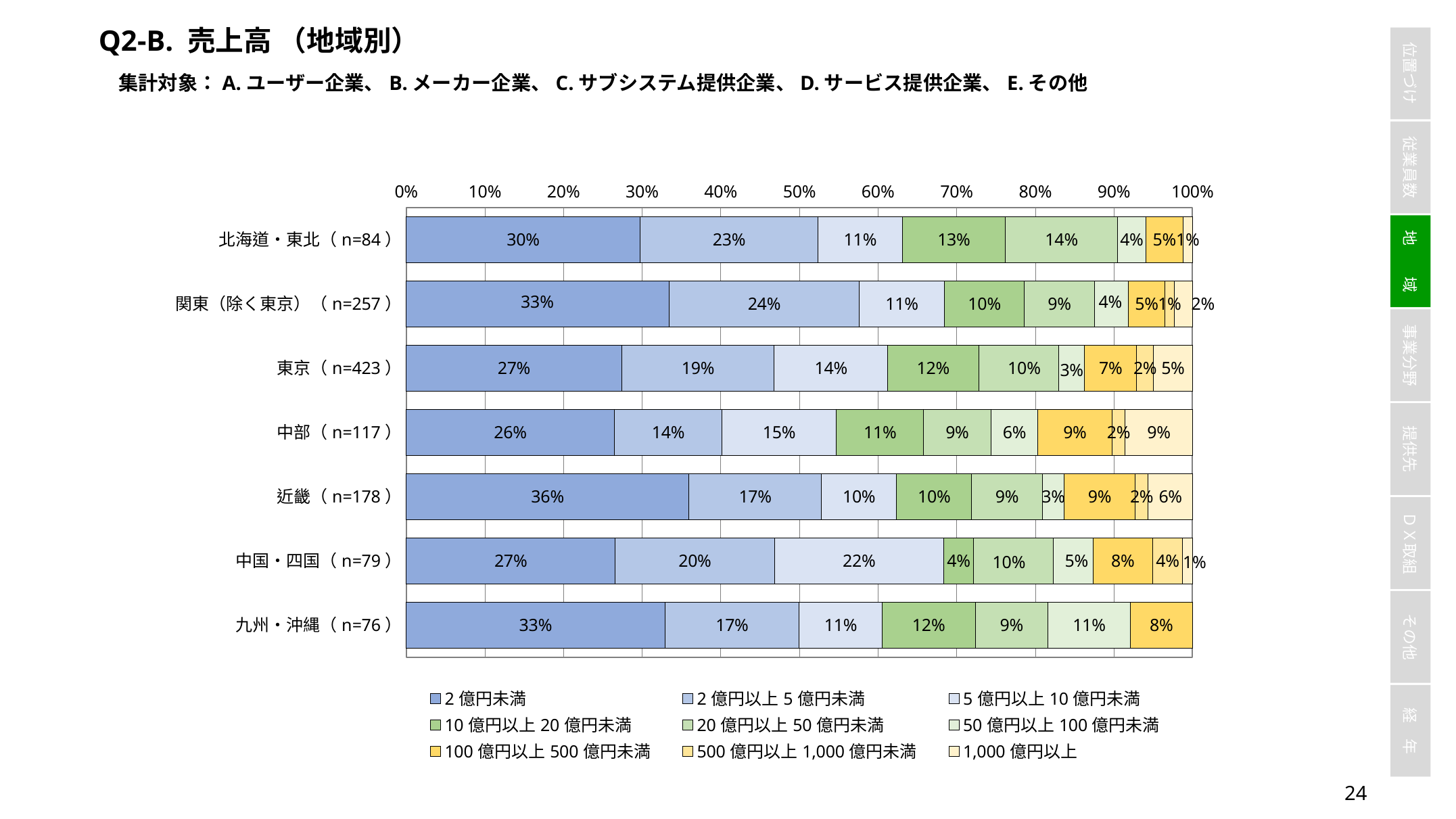
Which region has the highest value for 2 億円未満? 近畿 ( n=178 ) What is the sample size (n) shown for 関東（除く東京）? 257 How many series does the legend list? 9 Which has the larger value for 5 億円以上 10 億円未満: 中国・四国 ( n=79 ) or 東京 ( n=423 )? 中国・四国 ( n=79 ) How many regions (categories) are plotted in the chart? 7 What is the value of 2 億円未満 for 近畿 ( n=178 )? 36% Which region has the lowest value for 2 億円未満? 中部 ( n=117 ) What is the difference between the 2 億円未満 values for 近畿 ( n=178 ) and 中部 ( n=117 )? 10 percentage points What kind of chart is shown on the slide? Stacked bar chart What is the title of the slide? Q2-B. 売上高 （地域別） What is the value of 100 億円以上 500 億円未満 for 東京 ( n=423 )? 7% What is the value of 50 億円以上 100 億円未満 for 九州・沖縄 ( n=76 )? 11%